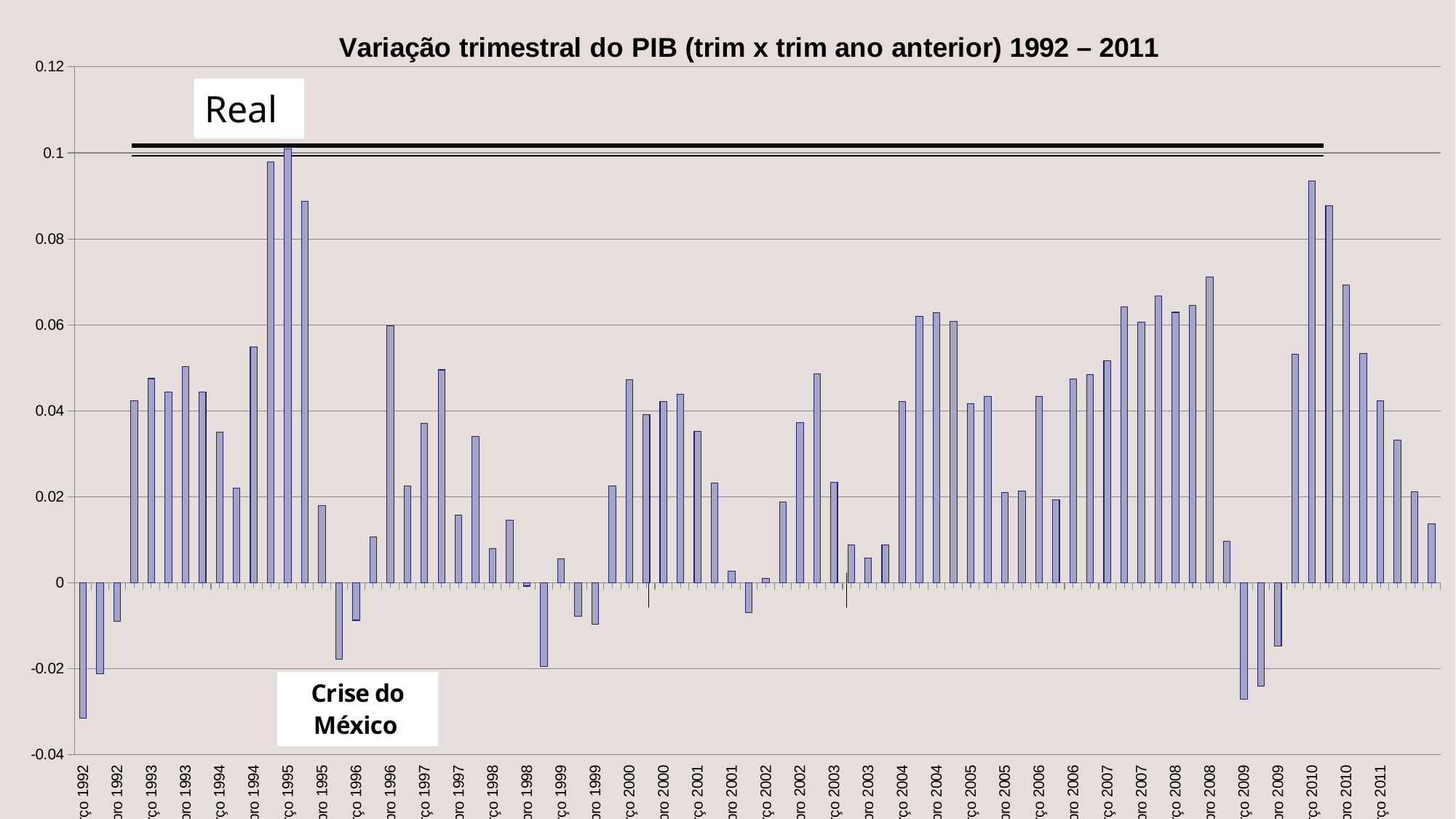
What text is shown in the box placed below the negative bars around 1995–1996? Crise do México Is the tallest bar in 1995 greater or less than 0.08? greater What type of chart is shown on the slide? Bar chart Is the lowest bar in 2009 greater or less than -0.02? less Is the tallest bar in 2008 greater or less than 0.06? greater In which year does the tallest bar of the chart occur? 1995 What is the title of the chart? Variação trimestral do PIB (trim x trim ano anterior) 1992 – 2011 Which is taller: the tallest bar in 1995 or the tallest bar in 2010? The tallest bar in 1995 Which bar has the lowest value in the chart? The leftmost bar (1992)